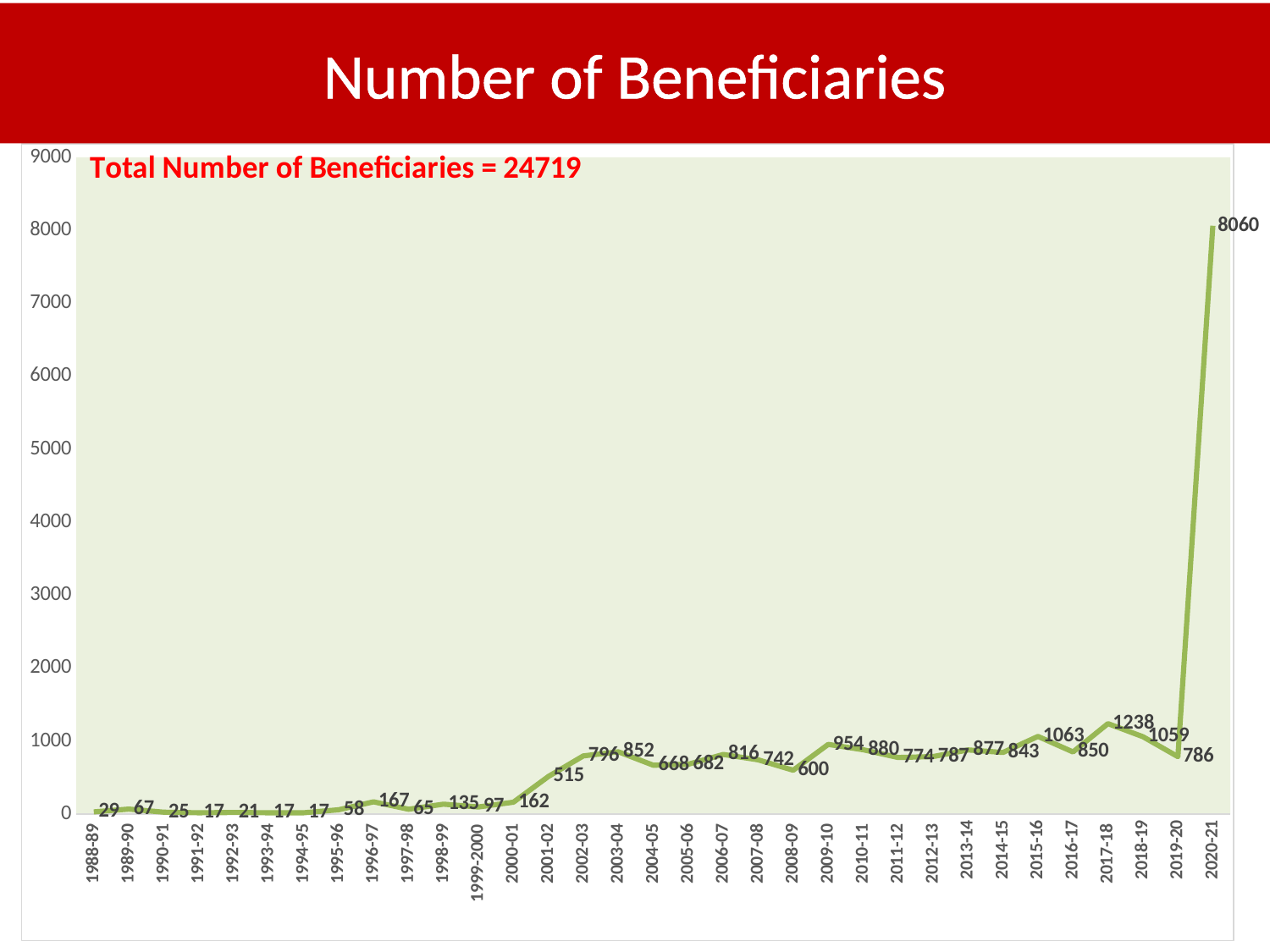
How many years are plotted on the chart? 33 What is the difference in beneficiaries between 2017-18 and 2018-19? 179 Which year has the highest number of beneficiaries? 2020-21 What is the number of beneficiaries for 2001-02? 515 Which year has more beneficiaries, 2009-10 or 2008-09? 2009-10 What total number of beneficiaries is stated on the chart? 24719 What type of chart is shown on the slide? line chart What is the number of beneficiaries for 1996-97? 167 What is the number of beneficiaries for 2017-18? 1238 What is the number of beneficiaries for 2020-21? 8060 What is the difference in beneficiaries between 2020-21 and 2019-20? 7274 What is the lowest number of beneficiaries shown on the chart? 17